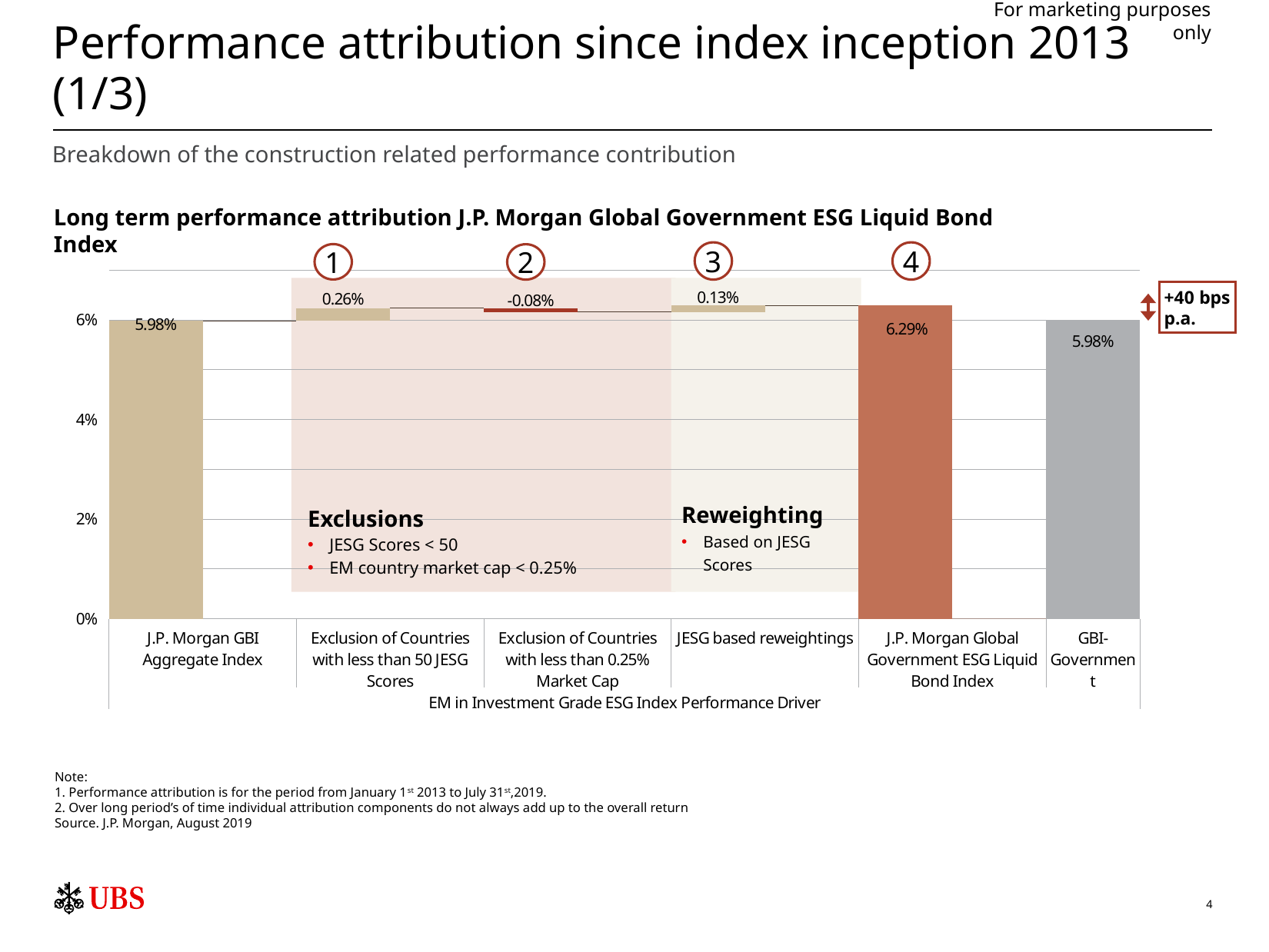
What is the contribution labelled for Exclusion of Countries with less than 50 JESG Scores? 0.26% What kind of chart is shown on the slide? Bar chart What is the value shown for the J.P. Morgan GBI Aggregate Index? 5.98% What is the contribution labelled for Exclusion of Countries with less than 0.25% Market Cap? -0.08% Which is larger: the contribution from Exclusion of Countries with less than 50 JESG Scores or from JESG based reweightings? Exclusion of Countries with less than 50 JESG Scores What is the contribution labelled for JESG based reweightings? 0.13% What is the value shown for GBI-Government? 5.98% What is the x-axis title of the chart? EM in Investment Grade ESG Index Performance Driver How many categories are shown on the x axis of the chart? 6 What is the difference between the J.P. Morgan Global Government ESG Liquid Bond Index value and the J.P. Morgan GBI Aggregate Index value? 0.31% Which category has the lowest labelled value in the chart? Exclusion of Countries with less than 0.25% Market Cap What is the value shown for the J.P. Morgan Global Government ESG Liquid Bond Index? 6.29%